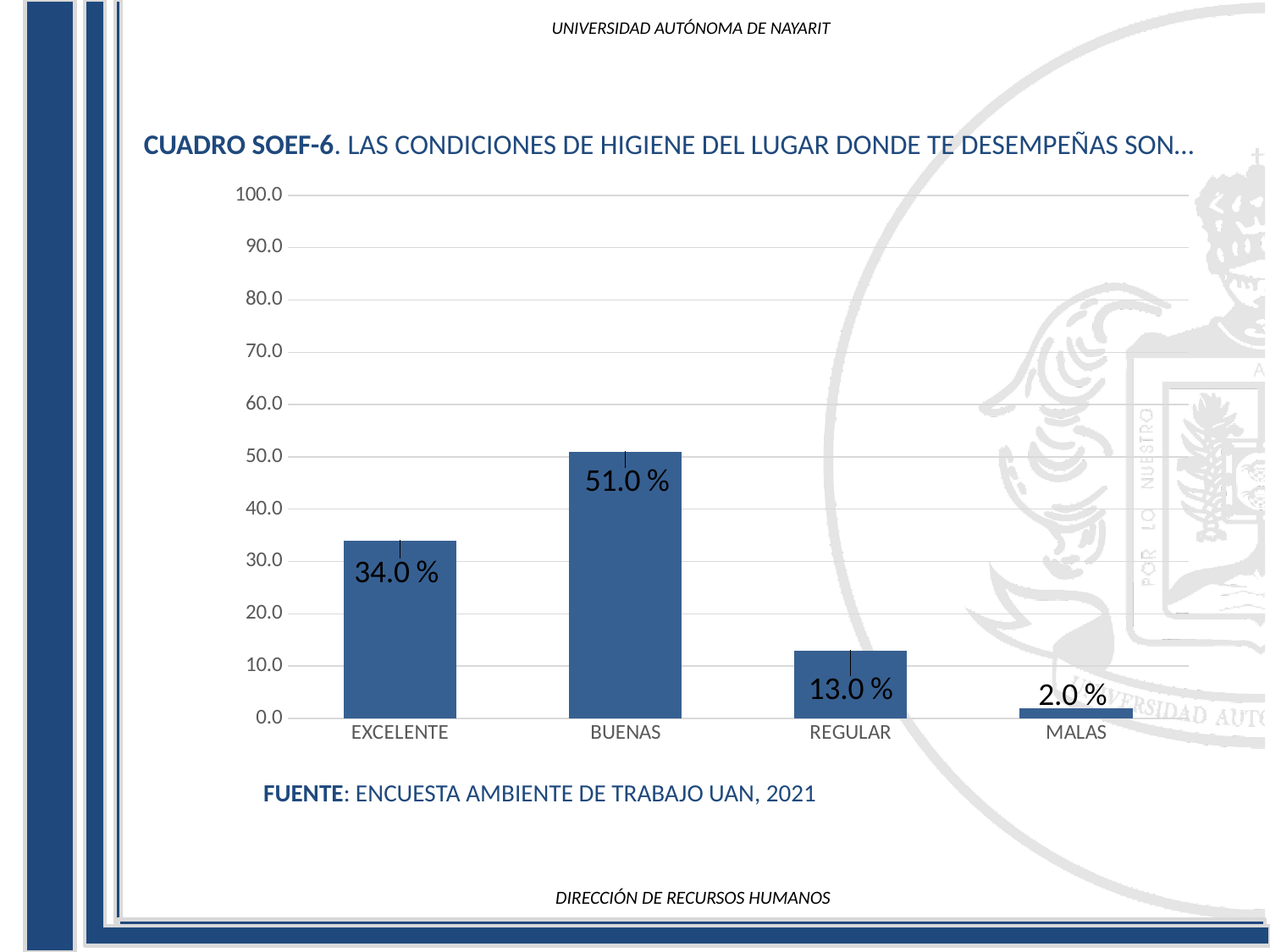
What is the value for BUENAS? 51.0 % What is the value for EXCELENTE? 34.0 % Is the value for EXCELENTE greater or less than 30.0? greater What source is cited below the chart? ENCUESTA AMBIENTE DE TRABAJO UAN, 2021 What is the value for MALAS? 2.0 % What is the value for REGULAR? 13.0 % What is the difference between the values for BUENAS and EXCELENTE? 17.0 % How many categories are shown on the x axis? 4 Which category has the highest value? BUENAS Which category has the lowest value? MALAS What kind of chart is shown on the slide? bar chart Which is larger, the value for REGULAR or the value for MALAS? REGULAR